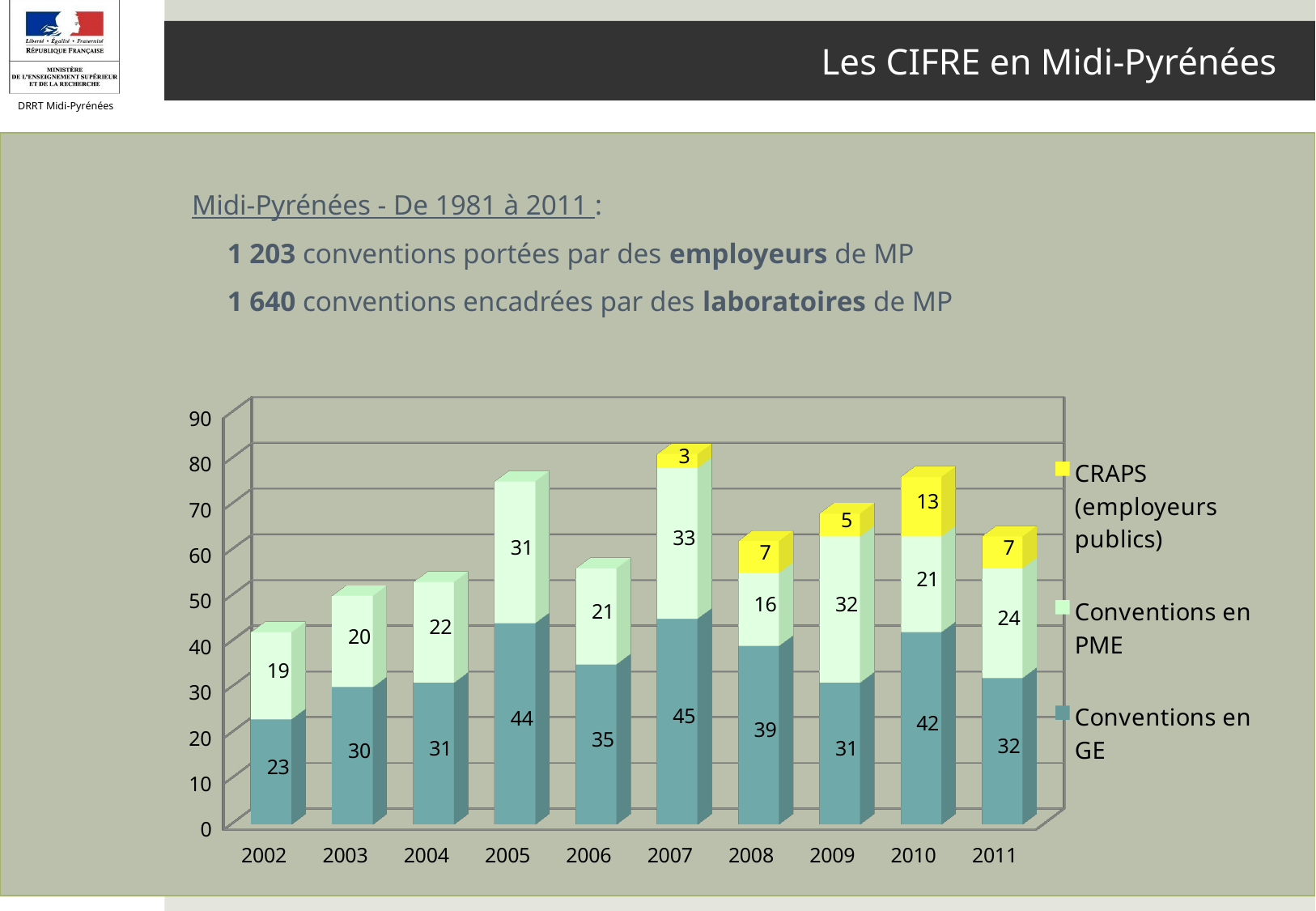
What kind of chart is shown on the slide? Stacked bar chart Which year has the highest value for Conventions en GE? 2007 How many years are shown on the x axis? 10 What is the value of Conventions en PME for 2008? 16 What is the difference between Conventions en GE and Conventions en PME in 2010? 21 Which series is shown in yellow? CRAPS (employeurs publics) What is the total of the stacked bar for 2007? 81 What is the value of Conventions en GE for 2005? 44 How many series does the legend list? 3 Which is larger in 2009, Conventions en GE or Conventions en PME? Conventions en PME Which year has the lowest value for Conventions en PME? 2008 What is the value of CRAPS (employeurs publics) for 2010? 13